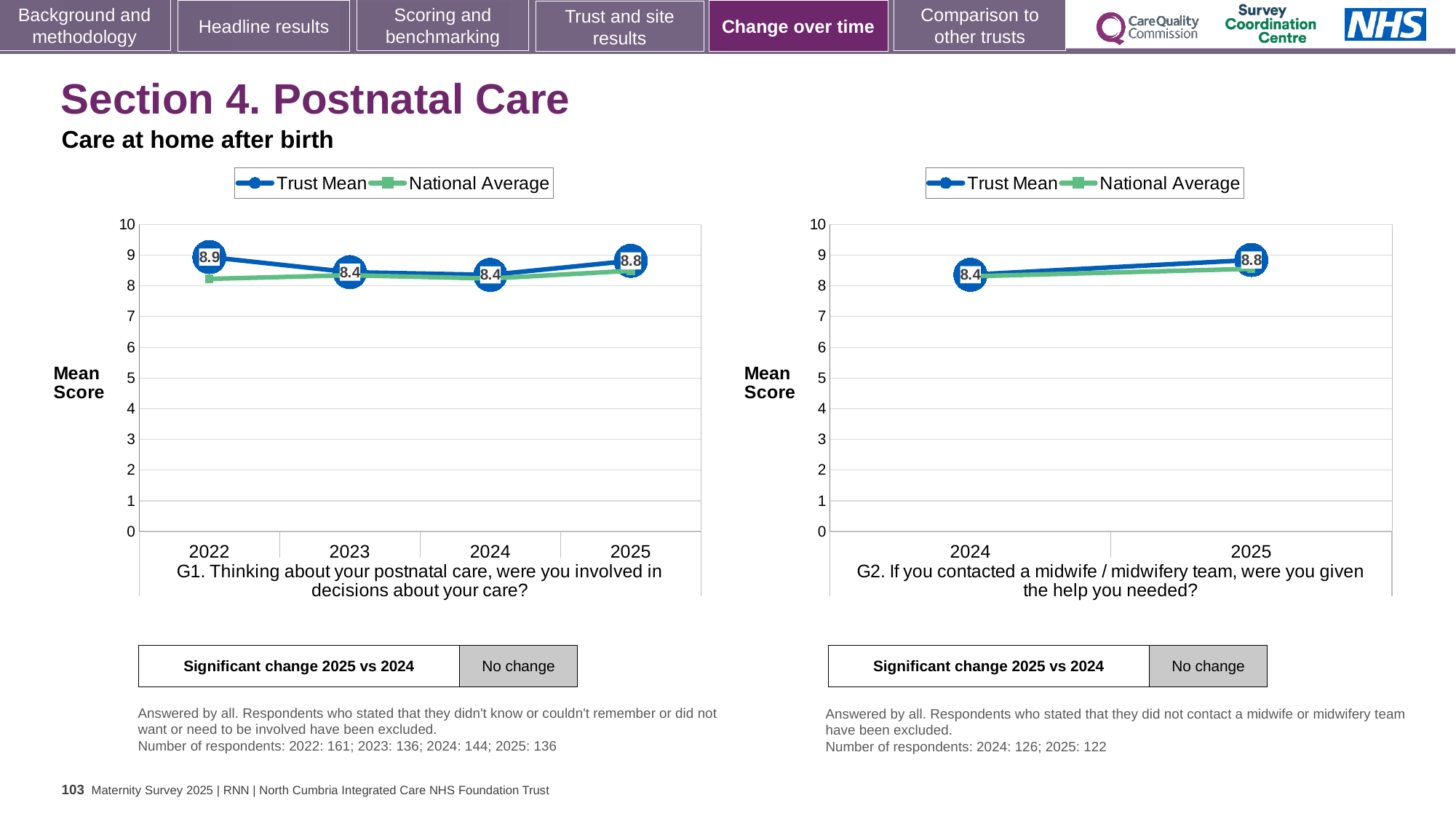
In the G2 chart on the right, what is the difference between the Trust Mean scores for 2025 and 2024? 0.4 In the G1 chart on the left, is the Trust Mean score higher in 2022 or in 2024? 2022 In the G1 chart on the left, what is the Trust Mean score for 2025? 8.8 In the G2 chart on the right, what is the Trust Mean score for 2024? 8.4 In the G1 chart on the left, what is the Trust Mean score for 2022? 8.9 In the G1 chart on the left, what is the difference between the Trust Mean scores for 2022 and 2023? 0.5 In the G1 chart on the left, what is the lowest Trust Mean score shown? 8.4 In the G2 chart on the right, what is the Trust Mean score for 2025? 8.8 In the G1 chart on the left, is the National Average value for 2025 greater or less than 7? greater In the G1 chart on the left, which year has the highest Trust Mean score? 2022 How many years are plotted on the x axis of the G1 chart on the left? 4 How many series does the legend of the G2 chart on the right list? 2